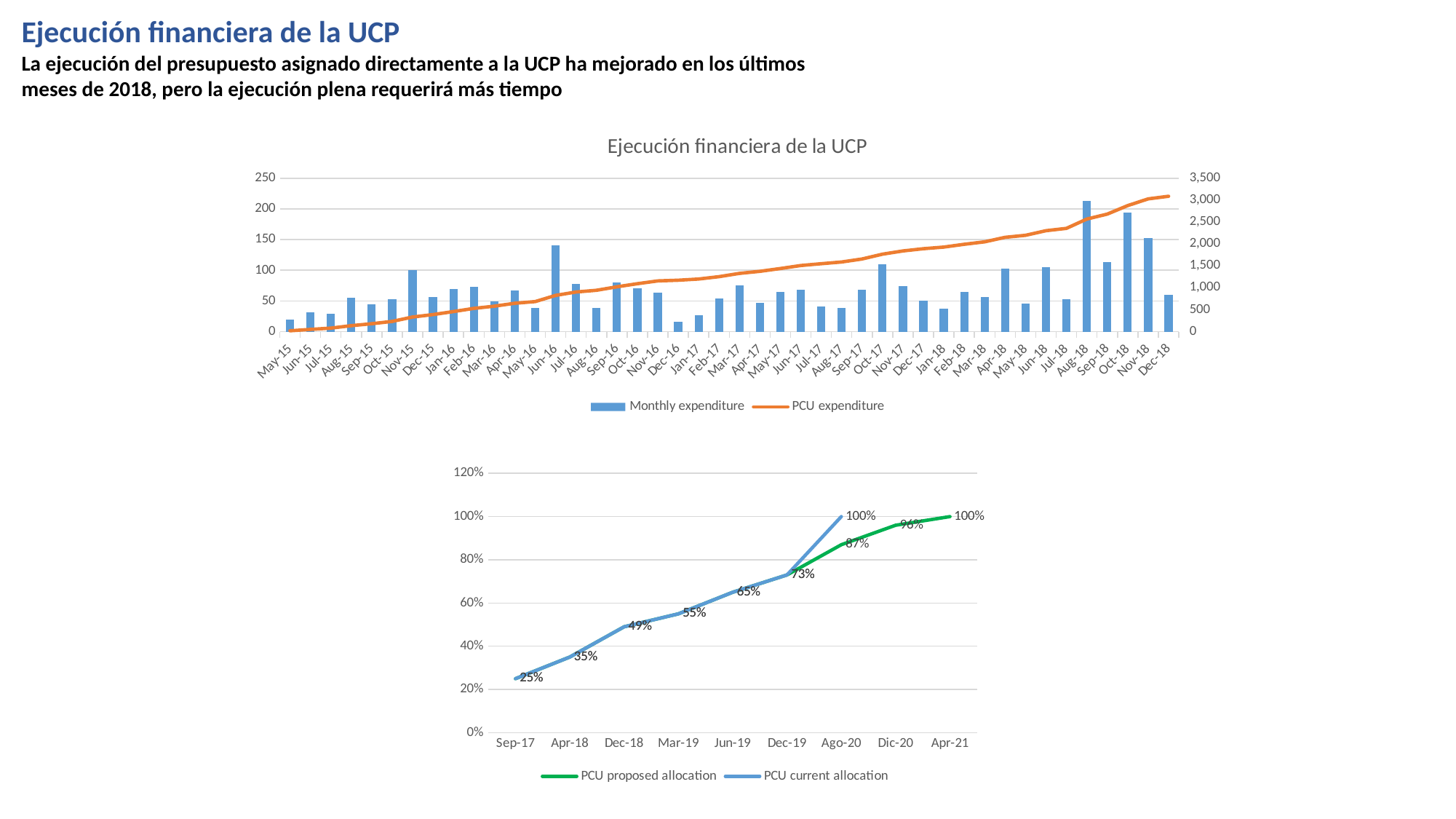
In the top chart 'Ejecución financiera de la UCP', is the monthly expenditure for Aug-18 greater or less than 200? greater What kind of chart is the bottom chart on the slide? A line chart In the bottom chart, what is the PCU proposed allocation value at Dic-20? 96% In the top chart 'Ejecución financiera de la UCP', which month has the highest monthly expenditure bar? Aug-18 In the top chart 'Ejecución financiera de la UCP', does the PCU expenditure line rise or fall from May-15 to Dec-18? It rises What kind of chart is the top chart titled 'Ejecución financiera de la UCP'? A combination bar and line chart In the bottom chart, which is larger: the allocation value at Apr-18 or at Mar-19? Mar-19 In the top chart 'Ejecución financiera de la UCP', is the monthly expenditure for Dec-16 greater or less than 50? less In the bottom chart, what is the difference between the PCU current allocation at Dec-19 and at Sep-17? 48 percentage points In the top chart 'Ejecución financiera de la UCP', how many series does the legend list? 2 In the bottom chart, how many dates are shown on the x axis? 9 In the bottom chart, what is the PCU current allocation value at Sep-17? 25%